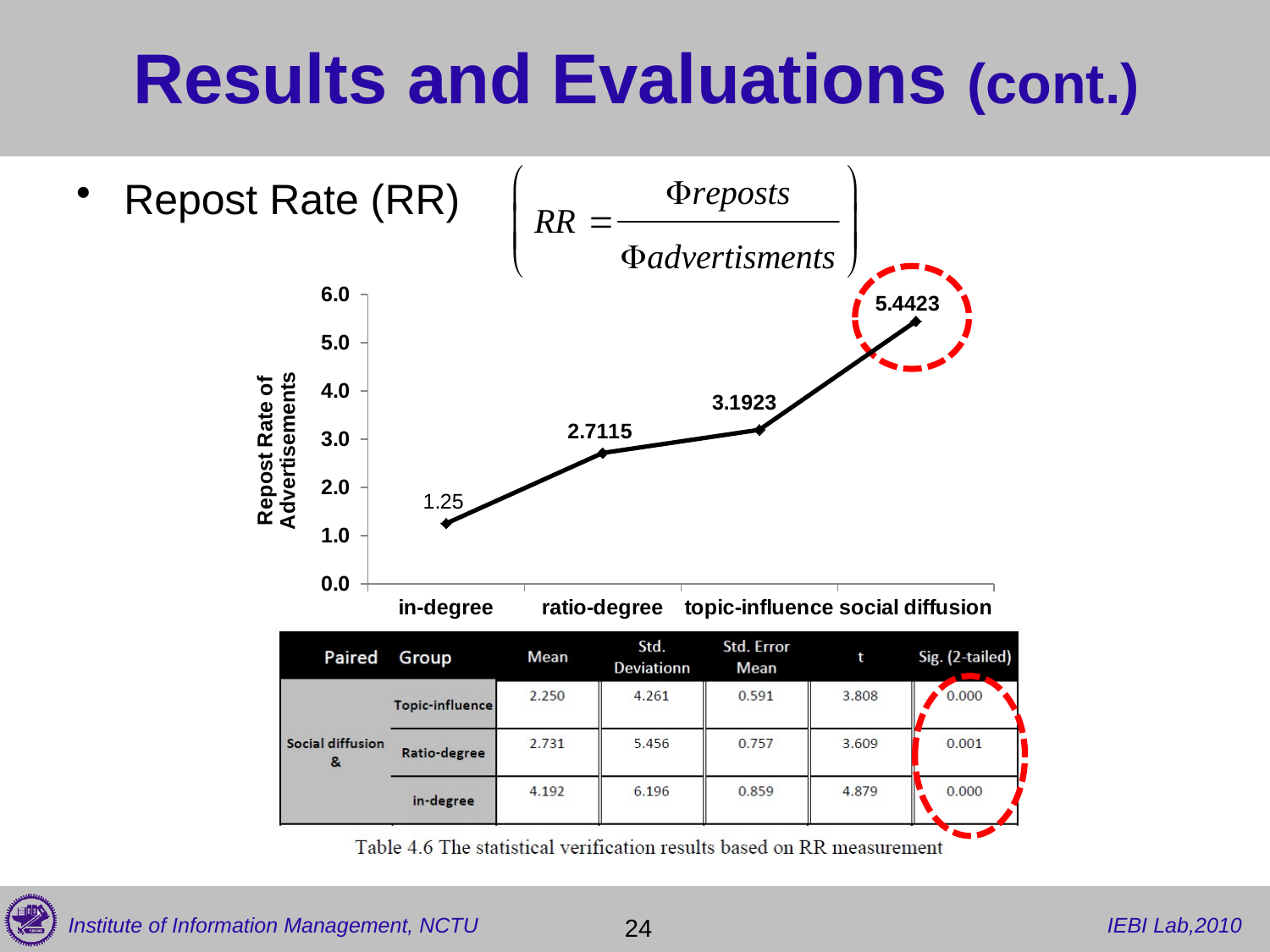
What kind of chart is shown on the slide? line chart Which category has the highest repost rate of advertisements? social diffusion How many categories are plotted on the x axis of the chart? 4 What is the difference in repost rate between social diffusion and topic-influence? 2.25 What is the repost rate of advertisements for in-degree? 1.25 Which has a higher repost rate, ratio-degree or topic-influence? topic-influence Do the values rise or fall from in-degree to social diffusion along the x axis? rise What is the repost rate of advertisements for ratio-degree? 2.7115 What is the repost rate of advertisements for social diffusion? 5.4423 Which category has the lowest repost rate of advertisements? in-degree Is the repost rate for social diffusion greater or less than 5.0? greater What is the repost rate of advertisements for topic-influence? 3.1923